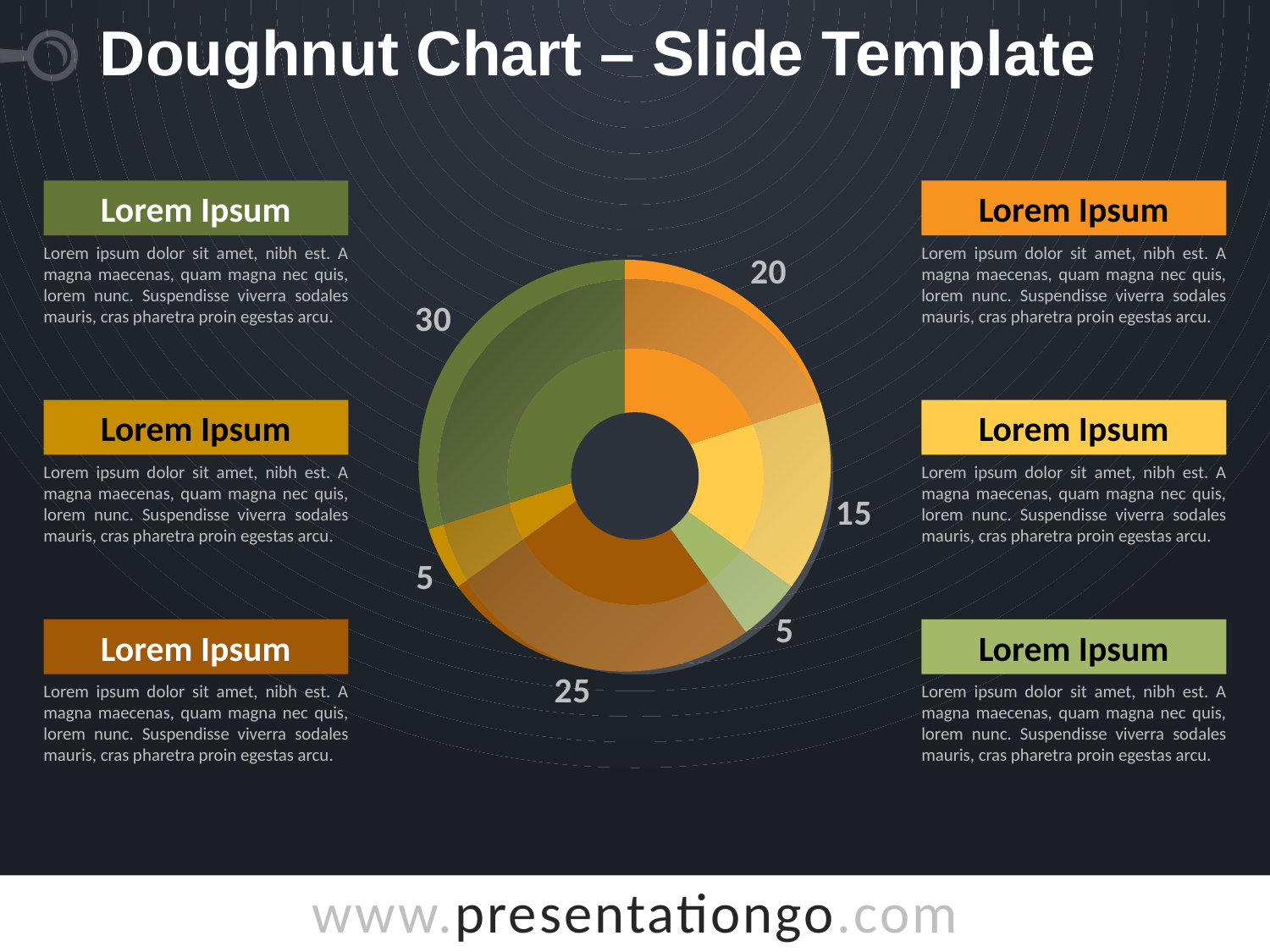
What is the title of the slide containing the chart? Doughnut Chart – Slide Template Which is larger, the orange slice or the yellow slice? the orange slice What is the difference between the largest slice (30) and the brown slice (25)? 5 What is the value of the olive green slice at the top left of the doughnut chart? 30 What kind of chart is shown on the slide? doughnut chart How many slices does the doughnut chart have? 6 What is the smallest value shown on the doughnut chart? 5 What is the value of the yellow slice on the right side of the doughnut chart? 15 What is the value of the orange slice at the top right of the doughnut chart? 20 What is the largest value shown on the doughnut chart? 30 What is the value of the brown slice at the bottom of the doughnut chart? 25 What is the total of all the values shown on the doughnut chart? 100